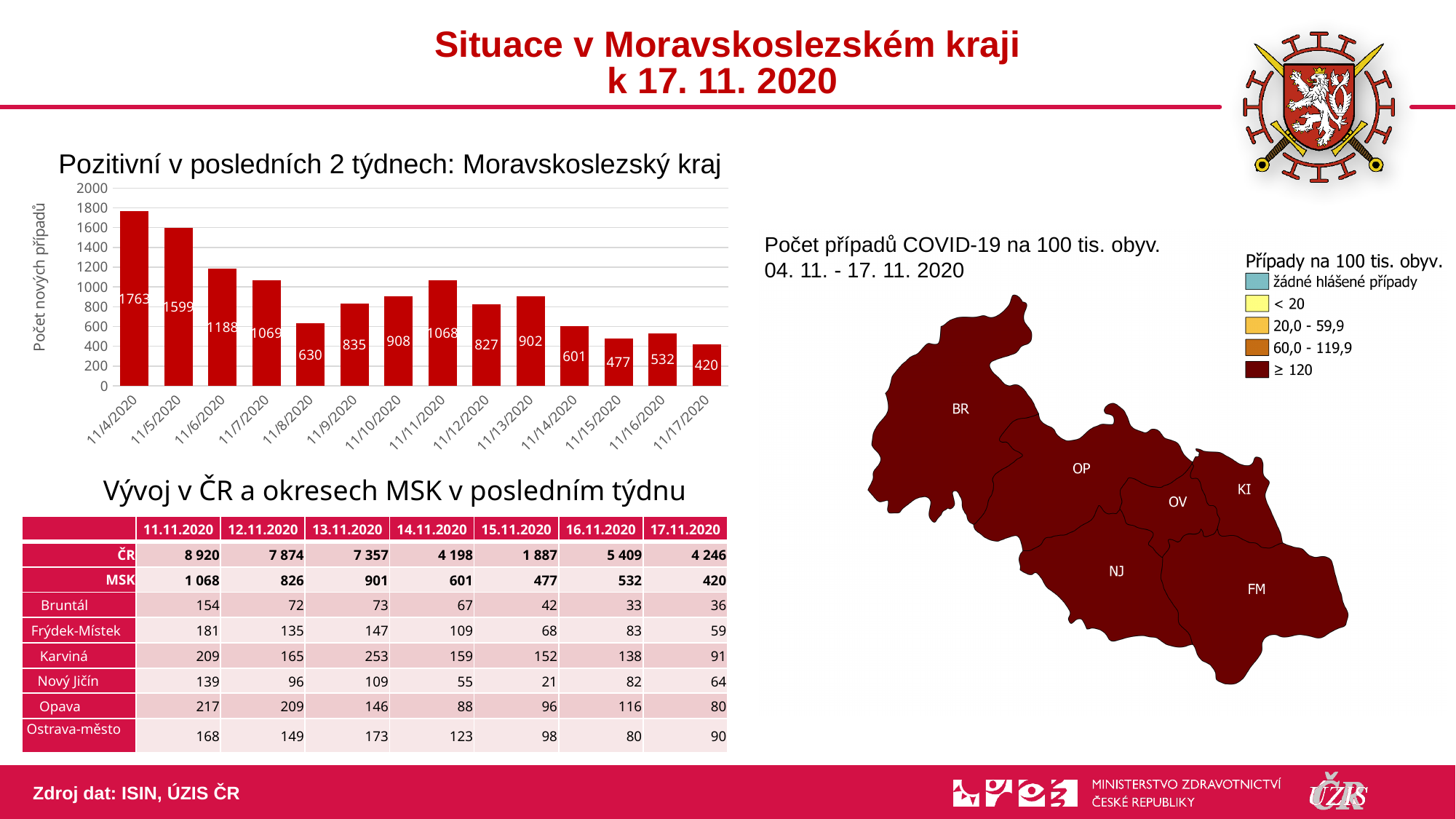
How many bars (dates) are shown in the bar chart? 14 What is the y-axis label of the bar chart? Počet nových případů In the bar chart, what is the value for 11/17/2020? 420 In the bar chart, what is the difference between the values for 11/4/2020 and 11/5/2020? 164 In the bar chart, which is larger, the value for 11/9/2020 or the value for 11/10/2020? 11/10/2020 In the bar chart, what is the value for 11/11/2020? 1068 In the bar chart, which date has the highest value? 11/4/2020 In the bar chart, what is the value for 11/4/2020? 1763 In the bar chart, do the values generally rise or fall from 11/4/2020 to 11/17/2020? fall In the bar chart, is the value for 11/6/2020 greater or less than 1000? greater What type of chart is shown under the title 'Pozitivní v posledních 2 týdnech: Moravskoslezský kraj'? bar chart In the bar chart, which date has the lowest value? 11/17/2020